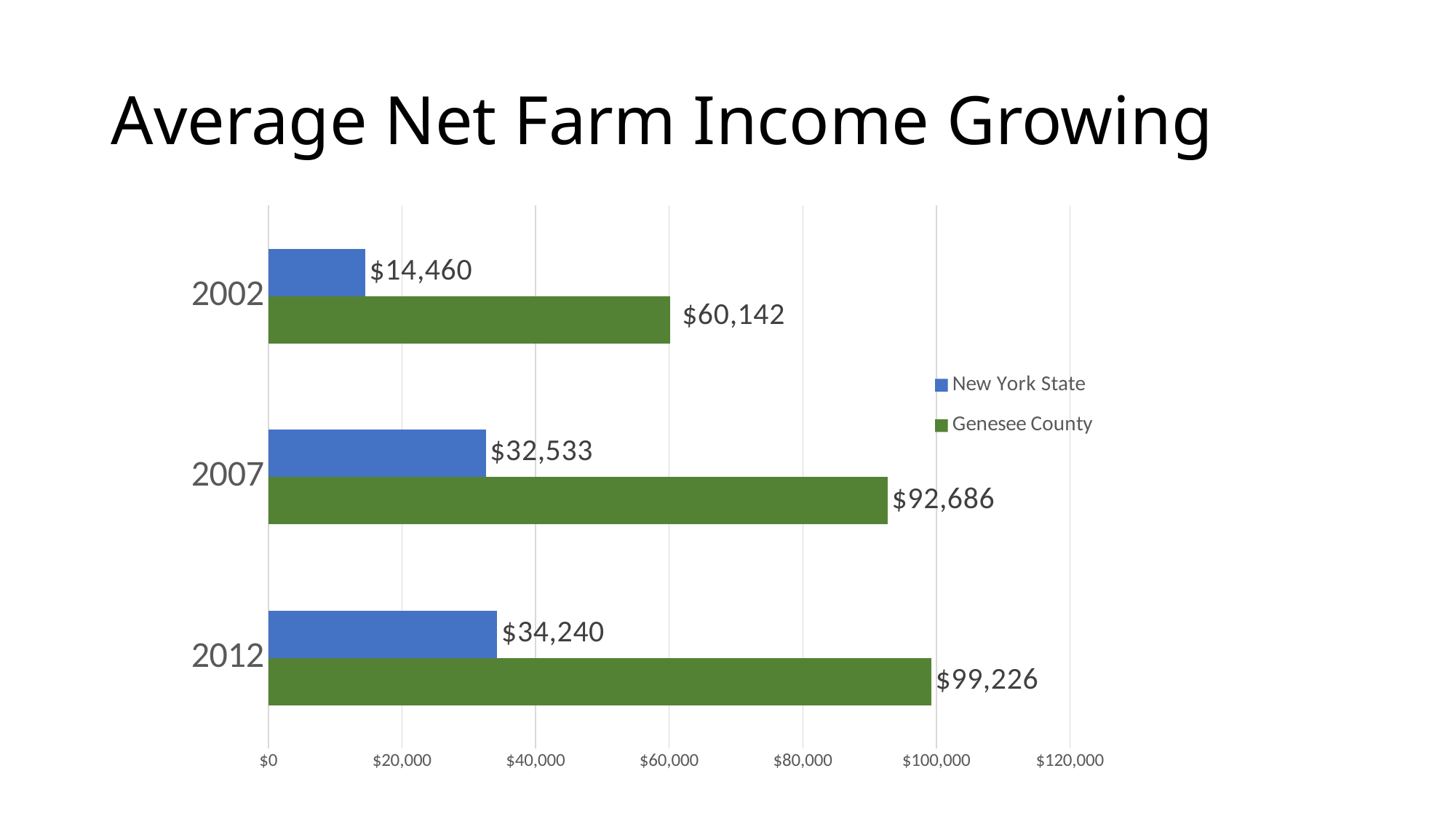
How many years are shown on the chart? 3 Which is larger in 2002: the Genesee County value or the New York State value? Genesee County What is the value for New York State in 2002? $14,460 In which year is the New York State value lowest? 2002 What is the value for New York State in 2012? $34,240 What is the value for Genesee County in 2012? $99,226 What kind of chart is shown on the slide? Bar chart What is the difference between the Genesee County and New York State values in 2007? $60,153 In which year is the Genesee County value highest? 2012 How many series does the legend list? 2 Do the Genesee County values rise or fall from 2002 to 2012? Rise What is the value for Genesee County in 2007? $92,686